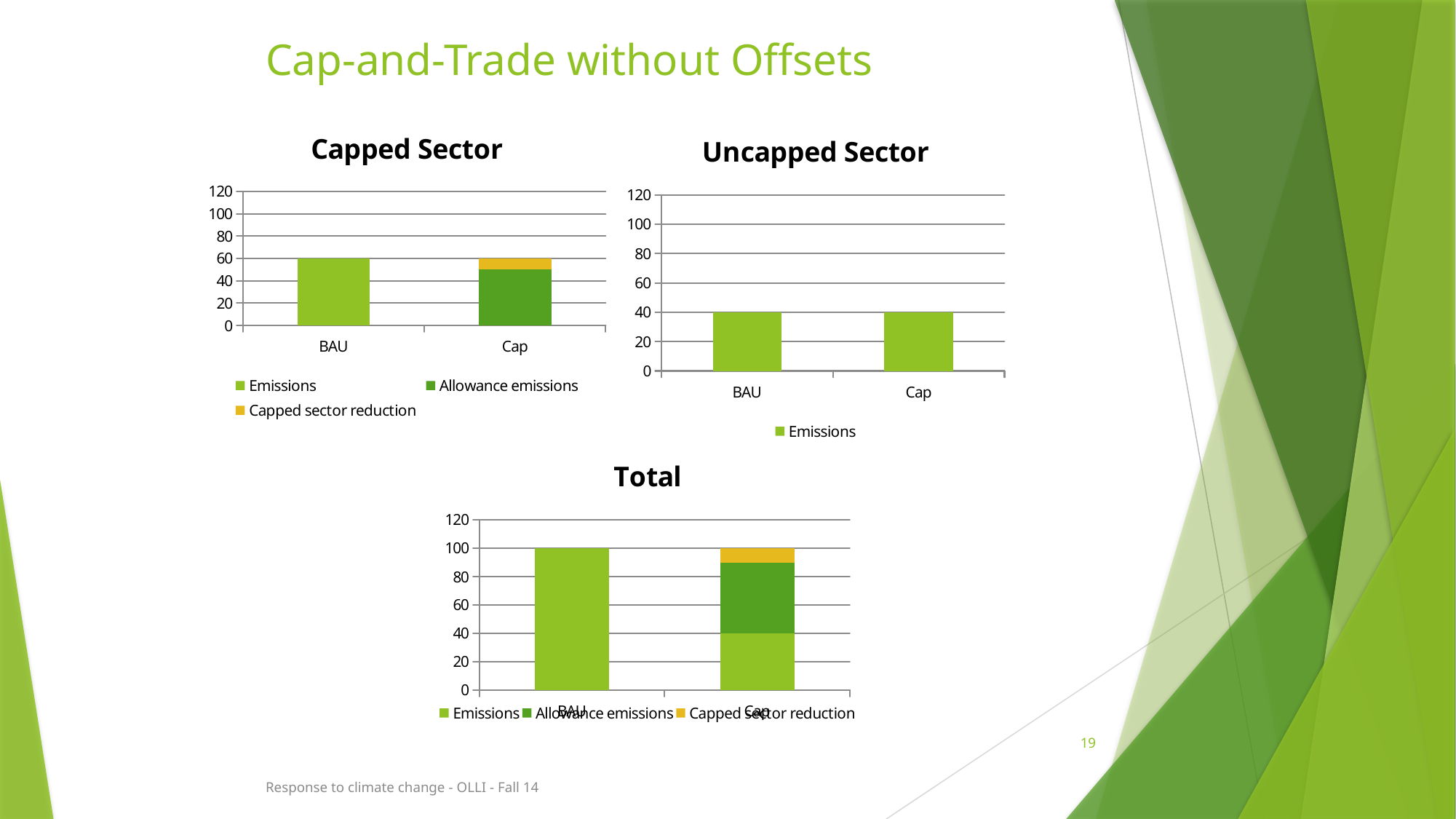
In the Capped Sector chart, which is larger: Emissions for BAU or Allowance emissions for Cap? Emissions for BAU How many series does the legend of the Capped Sector chart list? 3 In the Capped Sector chart, is the Allowance emissions value for Cap greater or less than 40? greater In the Uncapped Sector chart, what is the value of Emissions for Cap? 40 In the Total chart, what is the value of the Emissions segment for Cap? 40 In the Capped Sector chart, what is the value of Emissions for BAU? 60 In the Capped Sector chart, what is the total height of the stacked Cap bar? 60 In the Total chart, what is the value of Emissions for BAU? 100 In the Uncapped Sector chart, what is the value of Emissions for BAU? 40 In the Total chart, what is the total height of the stacked Cap bar? 100 What kind of chart is the Total chart? Bar chart How many series does the legend of the Uncapped Sector chart list? 1